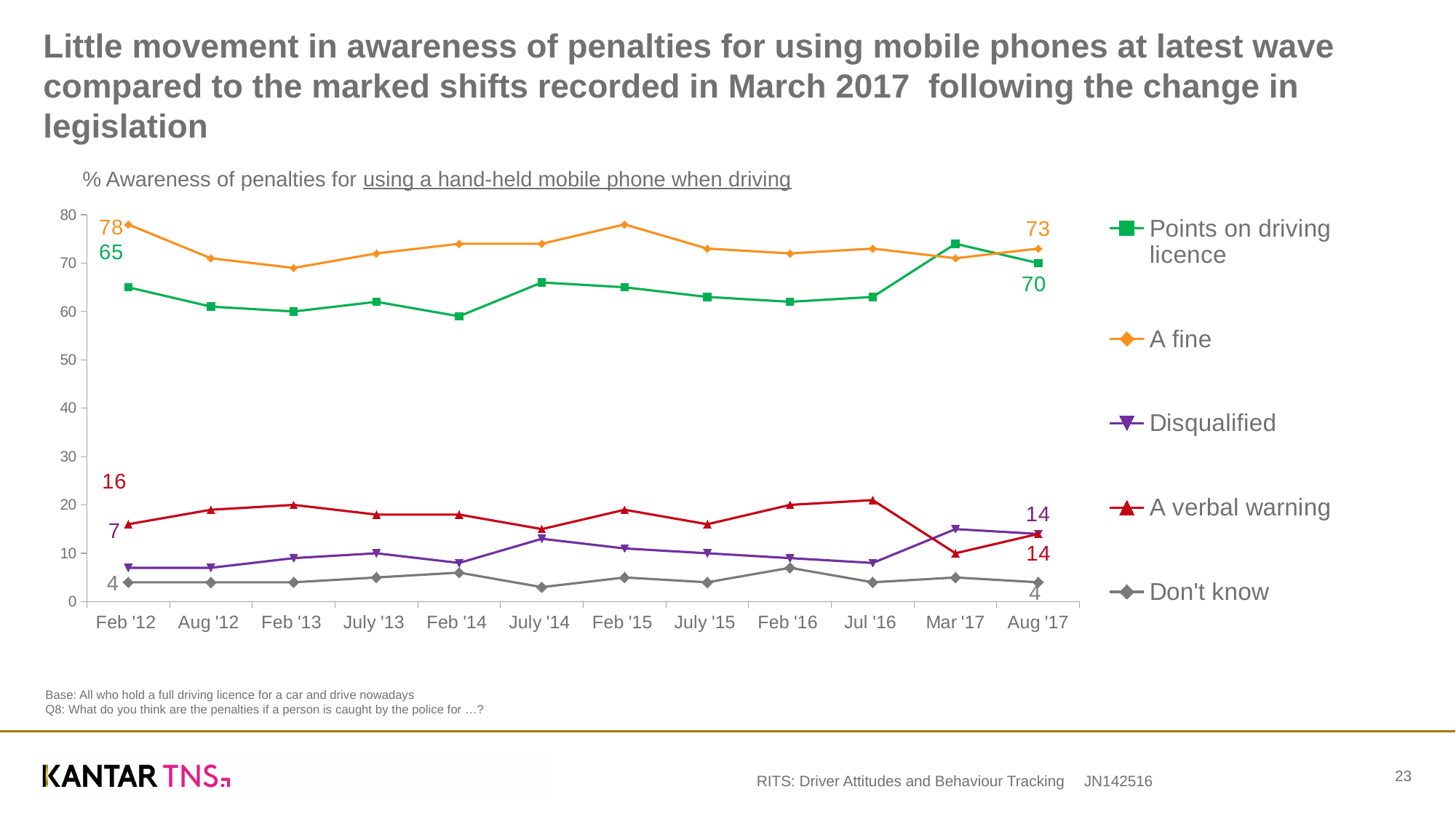
Which series has the lowest value in Aug '17? Don't know What is the value for 'Don't know' in Feb '12? 4 What is the value for 'A fine' in Feb '12? 78 Which is larger in Aug '17: 'A fine' or 'Points on driving licence'? A fine How many series does the legend list? 5 What is the difference between 'A fine' and 'Points on driving licence' in Feb '12? 13 How many time points are shown on the x axis? 12 What is the value for 'Points on driving licence' in Aug '17? 70 Which series has the highest value in Feb '12? A fine What type of chart is shown on the slide? line chart What is the value for 'Disqualified' in Aug '17? 14